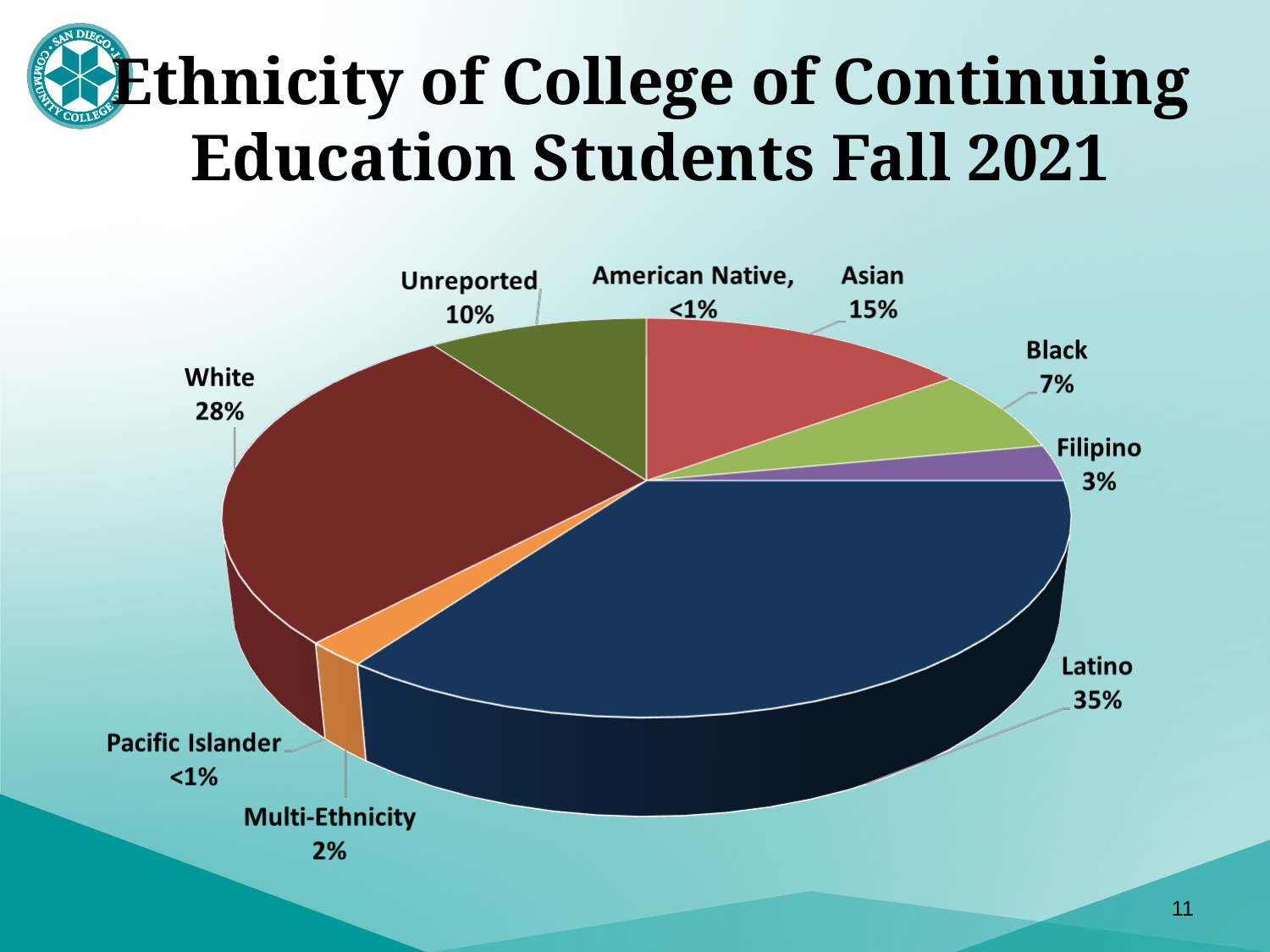
What is the value shown for Asian students? 15% What percentage is labelled as Unreported? 10% Which ethnicity category has the largest share of the pie? Latino What is the title of the chart on the slide? Ethnicity of College of Continuing Education Students Fall 2021 What share of students are Filipino? 3% What share of students are Latino? 35% What is the difference in percentage points between the Asian and Black shares? 8 What is the difference in percentage points between the Latino and White shares? 7 What percentage of students are White? 28% How many ethnicity categories are labelled on the pie chart? 9 What kind of chart is shown on the slide? Pie chart Which is larger, the share for Black students or the share for Filipino students? Black